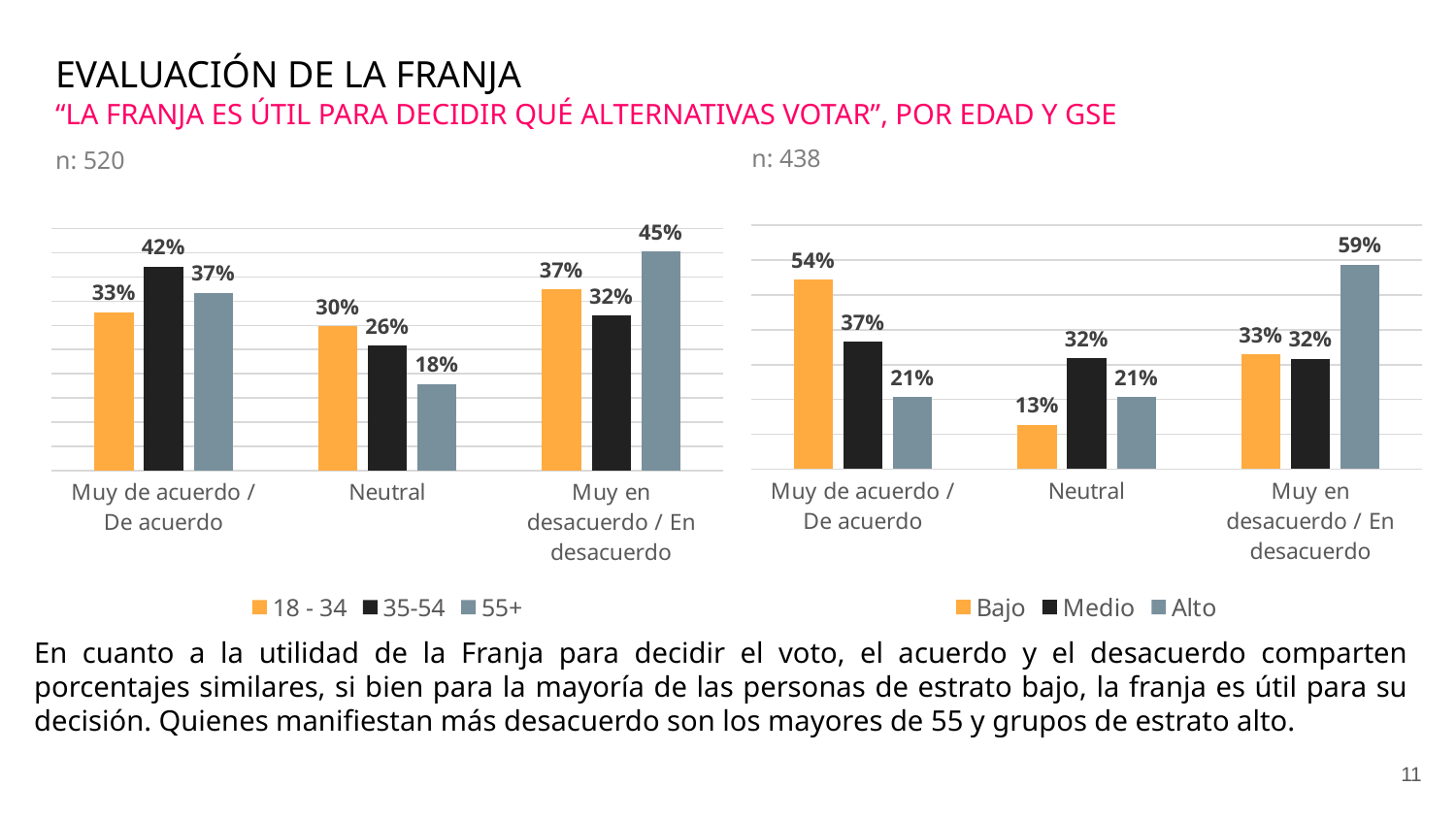
In the left chart (by age, n: 520), what is the difference between the 18 - 34 and 35-54 values in the 'Neutral' category? 4 percentage points In the left chart (by age, n: 520), what is the value for 35-54 in the 'Muy de acuerdo / De acuerdo' category? 42% In the right chart (by GSE, n: 438), what is the difference between Bajo and Alto in the 'Muy de acuerdo / De acuerdo' category? 33 percentage points In the left chart (by age, n: 520), which age group has the highest value in the 'Muy en desacuerdo / En desacuerdo' category? 55+ In the right chart (by GSE, n: 438), which group has the lowest value in the 'Neutral' category? Bajo How many series does the legend of the right chart (by GSE, n: 438) list? 3 In the left chart (by age, n: 520), what is the value for 55+ in the 'Neutral' category? 18% In the right chart (by GSE, n: 438), what is the value for Bajo in the 'Muy de acuerdo / De acuerdo' category? 54% What kind of chart is the right chart (by GSE, n: 438)? Bar chart In the right chart (by GSE, n: 438), what is the value for Alto in the 'Muy en desacuerdo / En desacuerdo' category? 59% How many categories are shown on the x axis of the left chart (by age, n: 520)? 3 In the left chart (by age, n: 520), which is larger: the 18 - 34 value or the 55+ value in the 'Muy de acuerdo / De acuerdo' category? 55+